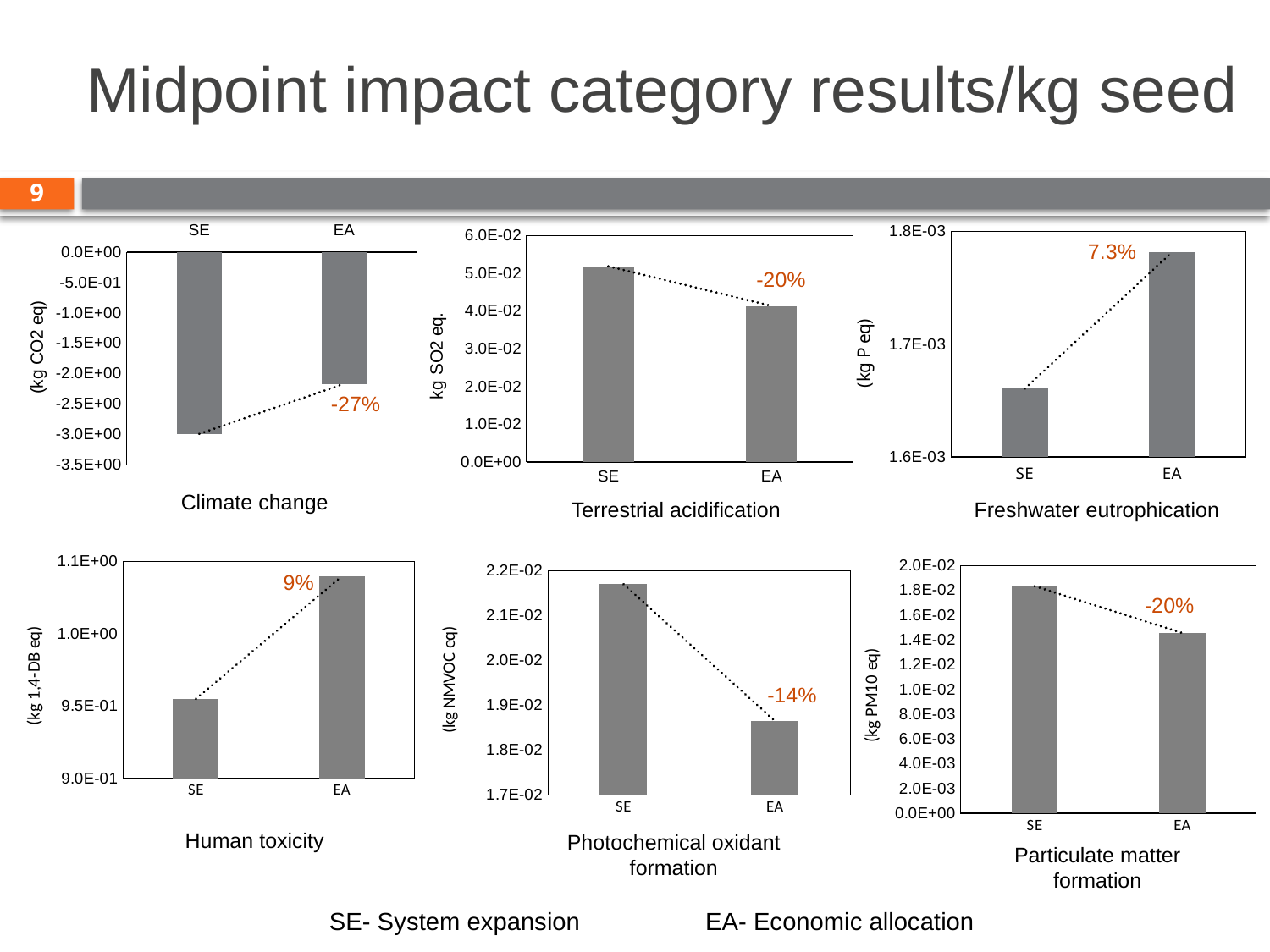
On the Terrestrial acidification chart, is the value for EA greater or less than 3.0E-02? greater How many categories are shown on the x axis of the Climate change chart? 2 On the Human toxicity chart, what percentage change is annotated between SE and EA? 9% What unit is shown on the y axis of the Climate change chart? (kg CO2 eq) On the Particulate matter formation chart, is the value for EA greater or less than 1.2E-02? greater On the Human toxicity chart, is the value for SE greater or less than 1.0E+00? less On the Climate change chart, what percentage change is annotated between SE and EA? -27% On the Freshwater eutrophication chart, what percentage change is annotated between SE and EA? 7.3% On the Human toxicity chart, which bar is taller, SE or EA? EA What kind of chart is the Particulate matter formation chart? bar chart On the Photochemical oxidant formation chart, what percentage change is annotated between SE and EA? -14% On the Terrestrial acidification chart, which bar is taller, SE or EA? SE